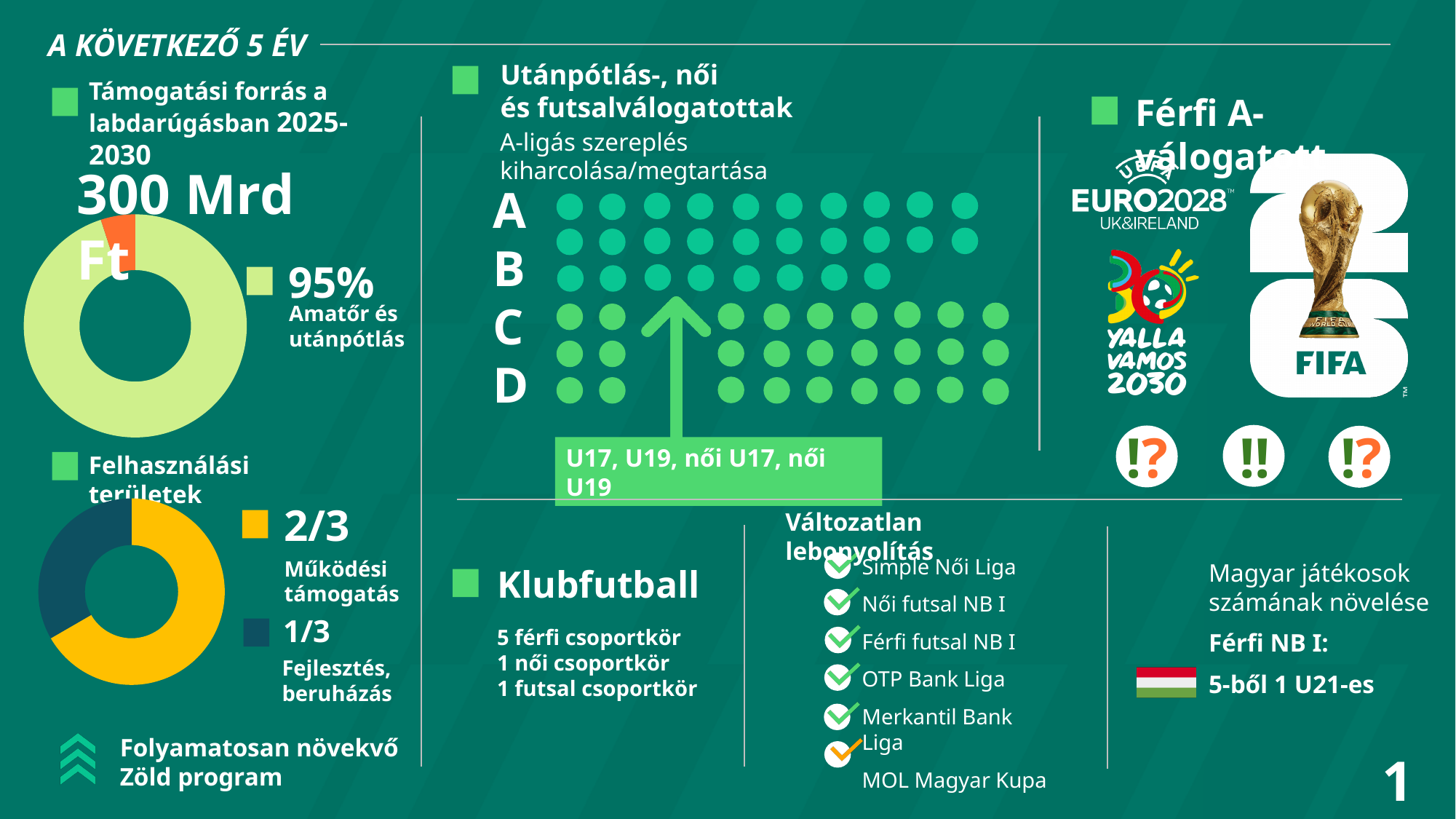
In the 'Támogatási forrás a labdarúgásban 2025-2030' chart, what colour is the 'Amatőr és utánpótlás' slice? light green In the 'Felhasználási területek' chart, which is larger: 'Működési támogatás' or 'Fejlesztés, beruházás'? Működési támogatás In the 'Támogatási forrás a labdarúgásban 2025-2030' chart, what share is labelled for 'Amatőr és utánpótlás'? 95% In the 'Felhasználási területek' chart, what colour is the 'Működési támogatás' slice? yellow In the 'Felhasználási területek' chart, what share is labelled for 'Fejlesztés, beruházás'? 1/3 How many slices does the 'Felhasználási területek' chart have? 2 In the 'Felhasználási területek' chart, what share is labelled for 'Működési támogatás'? 2/3 In the 'Felhasználási területek' chart, which slice is the smallest? Fejlesztés, beruházás What kind of chart is the 'Felhasználási területek' chart at the bottom left? doughnut chart What kind of chart is the 'Támogatási forrás a labdarúgásban 2025-2030' chart at the top left? doughnut chart In the 'Támogatási forrás a labdarúgásban 2025-2030' chart, which slice is the largest? Amatőr és utánpótlás